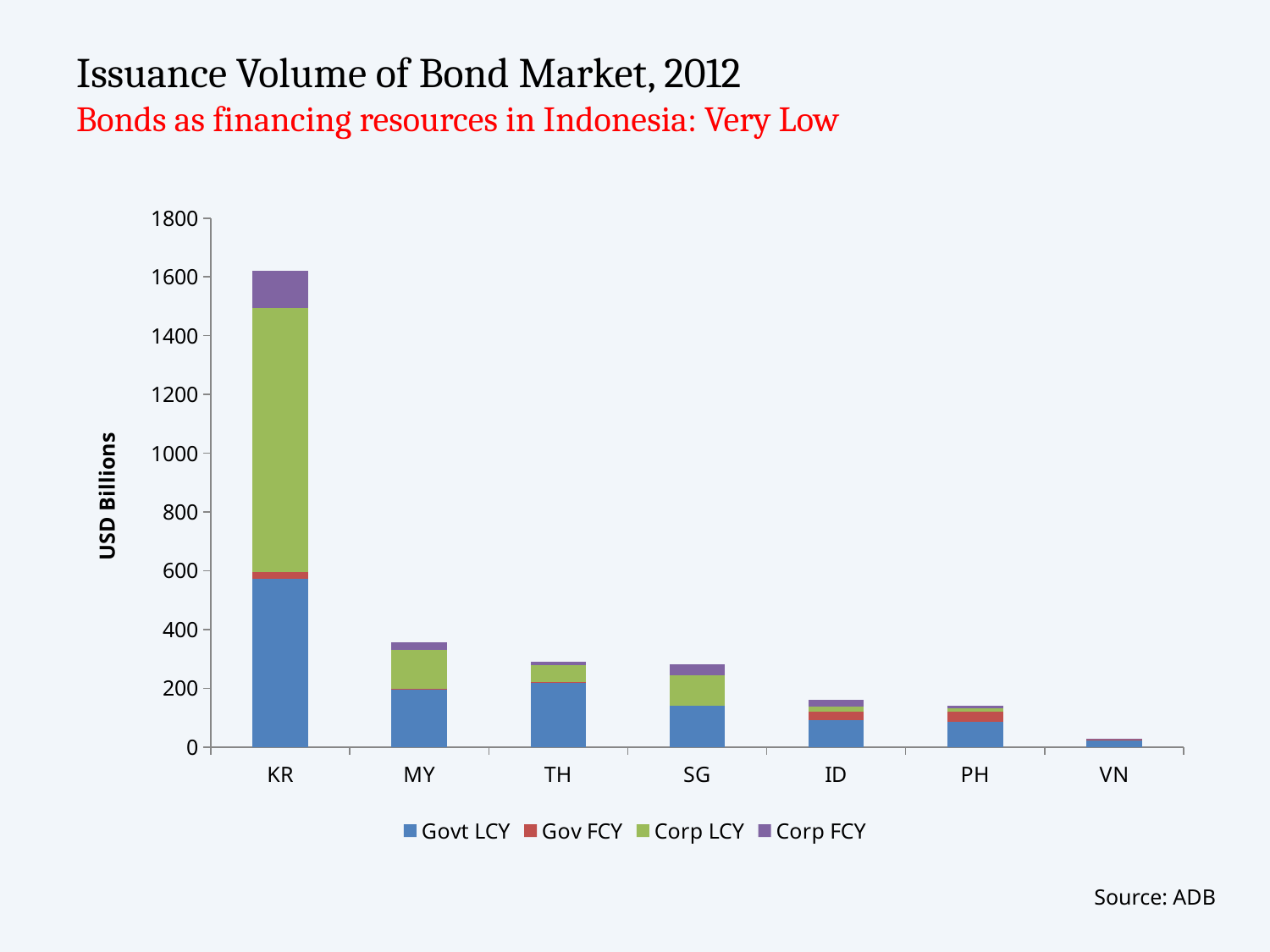
Is the total issuance volume for KR greater or less than 1400? greater Which series is shown in green in the chart? Corp LCY What is the label on the y axis of the chart? USD Billions Is the total issuance volume for MY greater or less than 200? greater Which country has the highest total issuance volume? KR Which has a larger total issuance volume, MY or ID? MY How many series does the legend list? 4 What kind of chart is shown on the slide? stacked bar chart Is the Govt LCY value for KR greater or less than 400? greater How many countries are shown on the x axis of the chart? 7 Which country has the lowest total issuance volume? VN